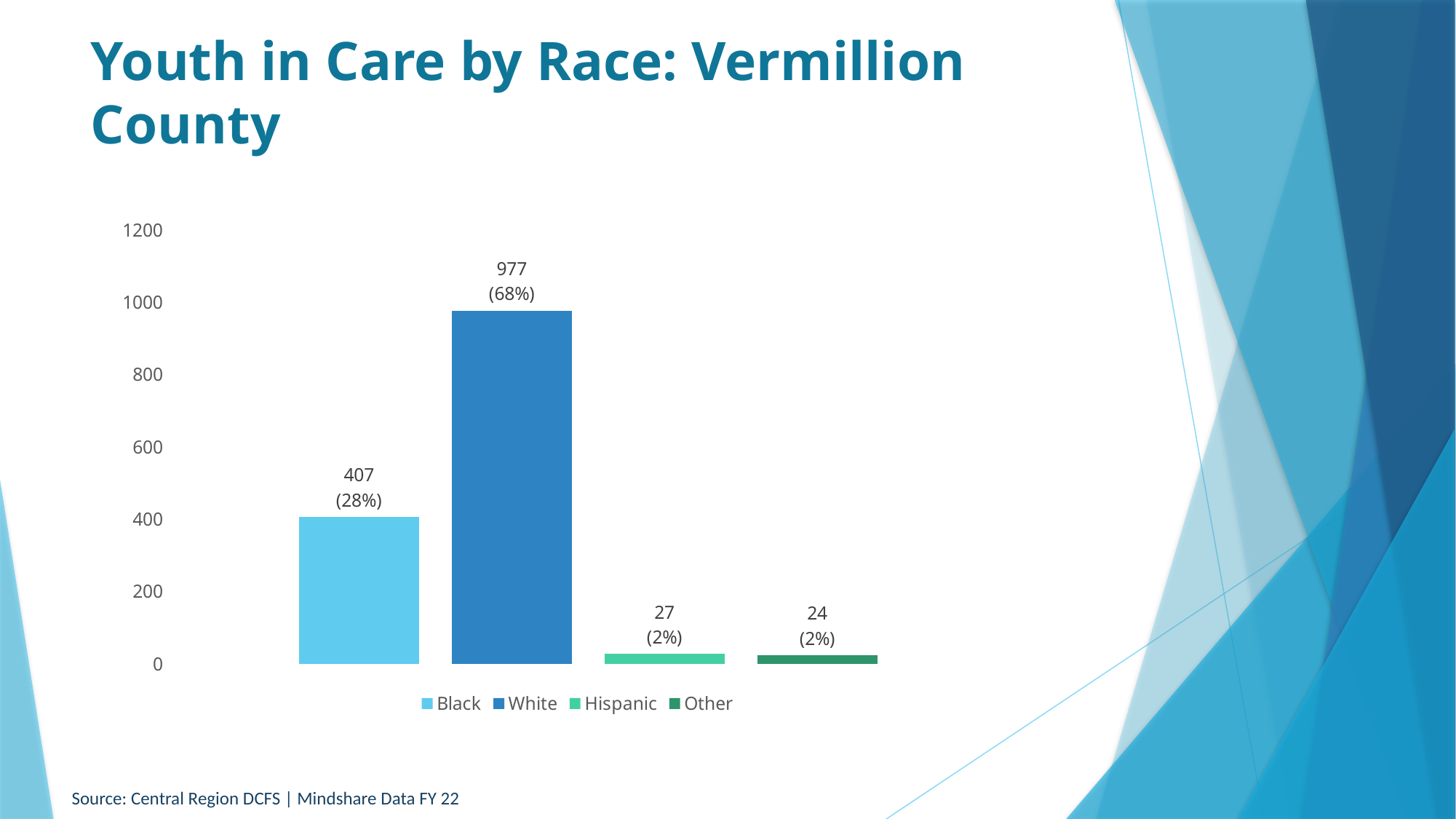
What is the number of youth in care for the White category? 977 What kind of chart is shown on the slide? Bar chart Which category has the lowest number of youth in care? Other What is the number of youth in care for the Black category? 407 Which category has the highest number of youth in care? White What is the difference between the White and Black values? 570 What is the title of the slide? Youth in Care by Race: Vermillion County What is the number of youth in care for the Other category? 24 How many categories are shown in the chart? 4 Which is larger, the value for Black or the value for Hispanic? Black What percentage is shown for the Hispanic category? 2% Is the value for White greater or less than 800? greater